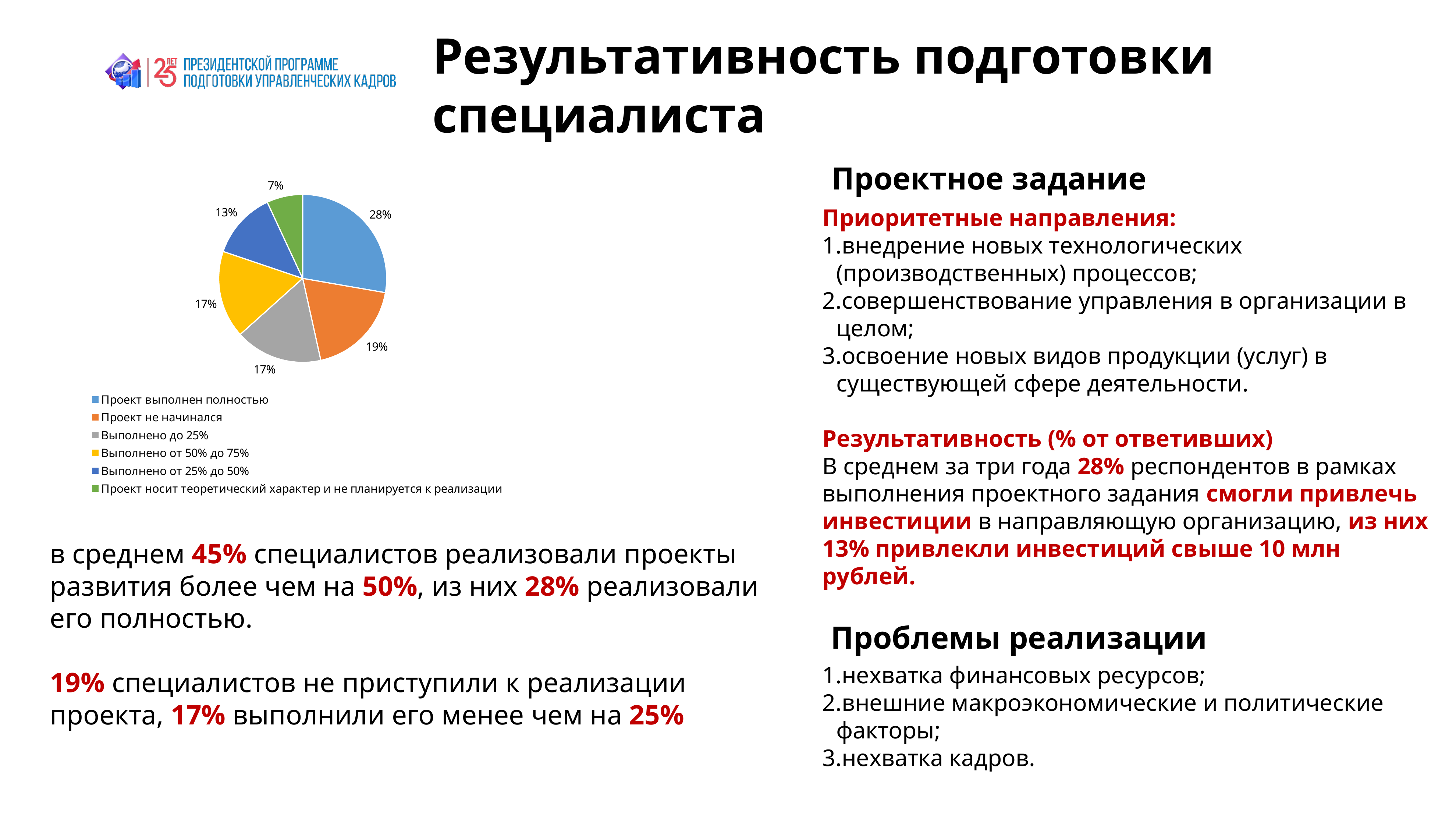
Which is larger: the slice for "Выполнено от 25% до 50%" or the slice for "Выполнено от 50% до 75%"? Выполнено от 50% до 75% How many categories does the pie chart legend list? 6 Which category has the smallest slice of the pie? Проект носит теоретический характер и не планируется к реализации Which category has the largest slice of the pie? Проект выполнен полностью What colour is the slice for "Выполнено до 25%"? gray What is the difference in percentage points between "Проект выполнен полностью" and "Проект не начинался"? 9 What percentage of the pie corresponds to "Выполнено от 25% до 50%"? 13% What percentage of the pie corresponds to "Проект выполнен полностью"? 28% What percentage of the pie corresponds to "Проект носит теоретический характер и не планируется к реализации"? 7% What colour is the slice for "Проект не начинался"? orange What percentage of the pie corresponds to "Проект не начинался"? 19% What kind of chart is shown on the slide? pie chart